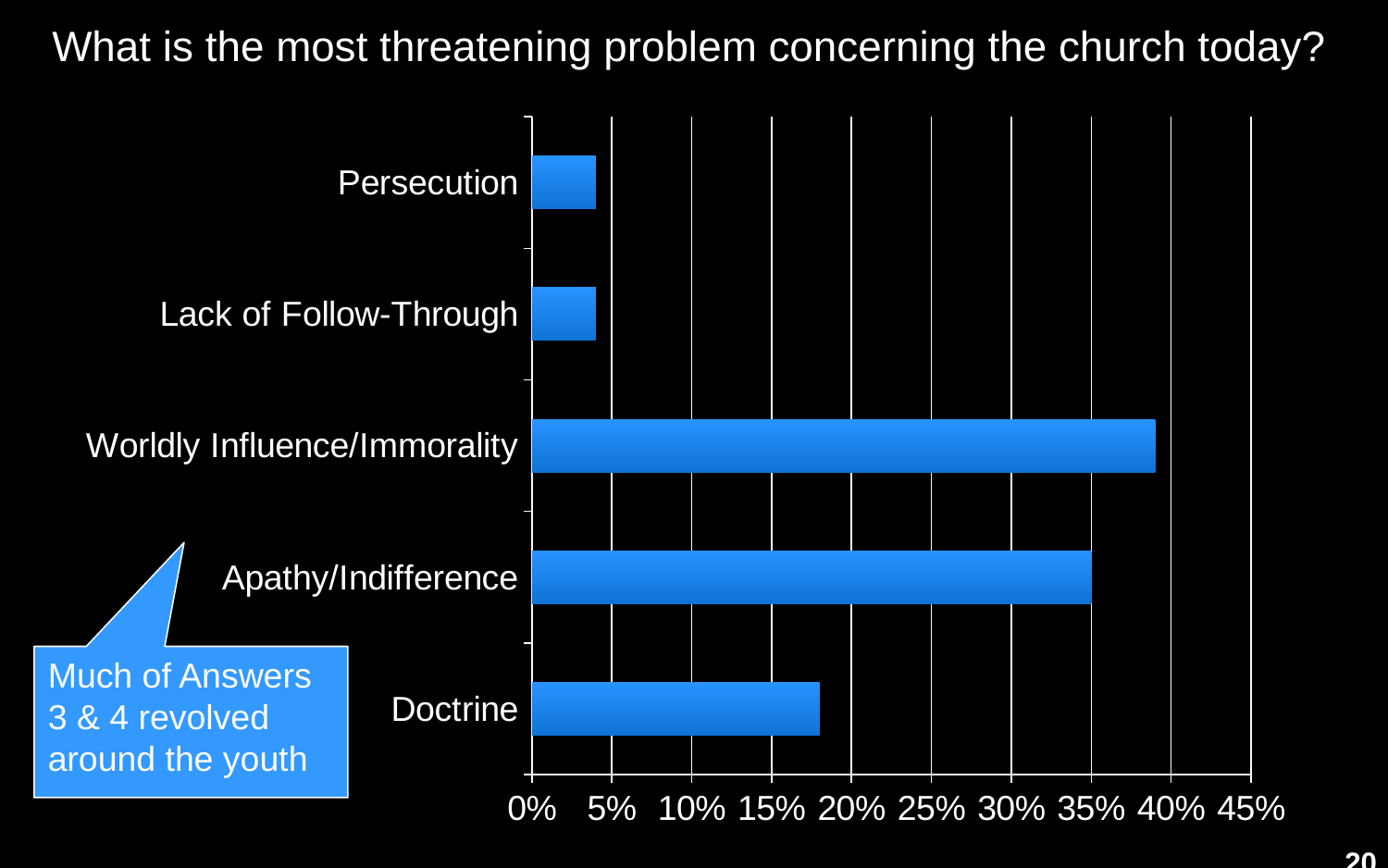
What is the title of the chart? What is the most threatening problem concerning the church today? Is the value for Apathy/Indifference greater or less than 30%? greater Which category has the highest value? Worldly Influence/Immorality Which is larger, the value for Worldly Influence/Immorality or the value for Apathy/Indifference? Worldly Influence/Immorality Is the value for Doctrine greater or less than 20%? less Is the value for Worldly Influence/Immorality greater or less than 35%? greater Which is larger, the value for Doctrine or the value for Persecution? Doctrine What kind of chart is shown on the slide? bar chart What does the callout box on the slide say? Much of Answers 3 & 4 revolved around the youth How many categories are plotted in the chart? 5